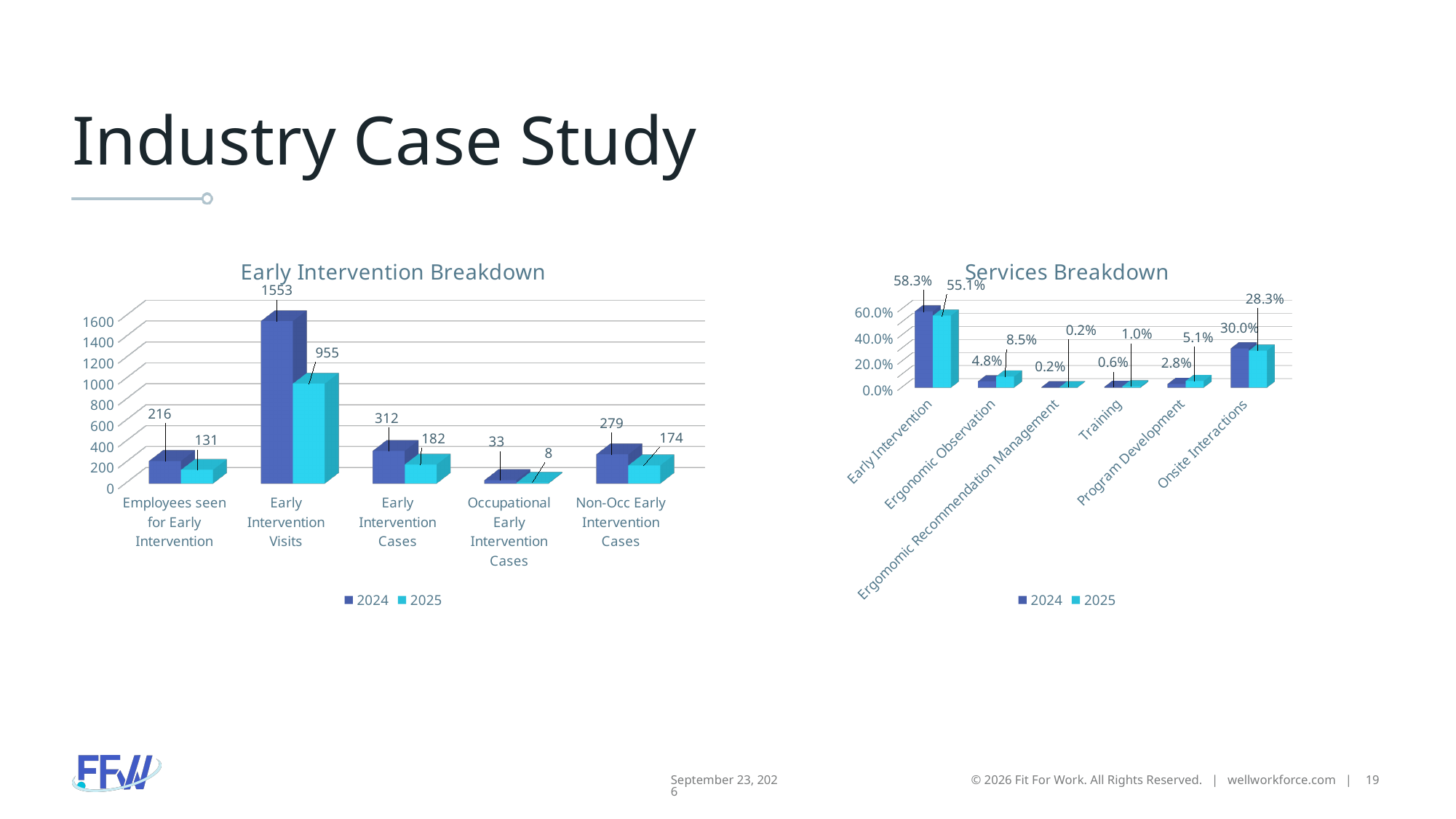
In the Services Breakdown chart, which category has the highest 2024 value? Early Intervention In the Early Intervention Breakdown chart, is the 2024 value for Employees seen for Early Intervention larger or smaller than the 2025 value? larger In the Early Intervention Breakdown chart, what is the difference between the 2024 and 2025 values for Early Intervention Visits? 598 In the Early Intervention Breakdown chart, which category has the lowest 2025 value? Occupational Early Intervention Cases In the Early Intervention Breakdown chart, which category has the highest 2024 value? Early Intervention Visits How many categories are shown in the Early Intervention Breakdown chart? 5 In the Early Intervention Breakdown chart, what is the 2025 value for Non-Occ Early Intervention Cases? 174 In the Early Intervention Breakdown chart, what is the 2024 value for Early Intervention Visits? 1553 How many series does the legend of the Services Breakdown chart list? 2 What type of chart is the Services Breakdown chart? bar chart In the Services Breakdown chart, what is the 2025 value for Ergonomic Observation? 8.5% In the Services Breakdown chart, what is the 2024 value for Onsite Interactions? 30.0%